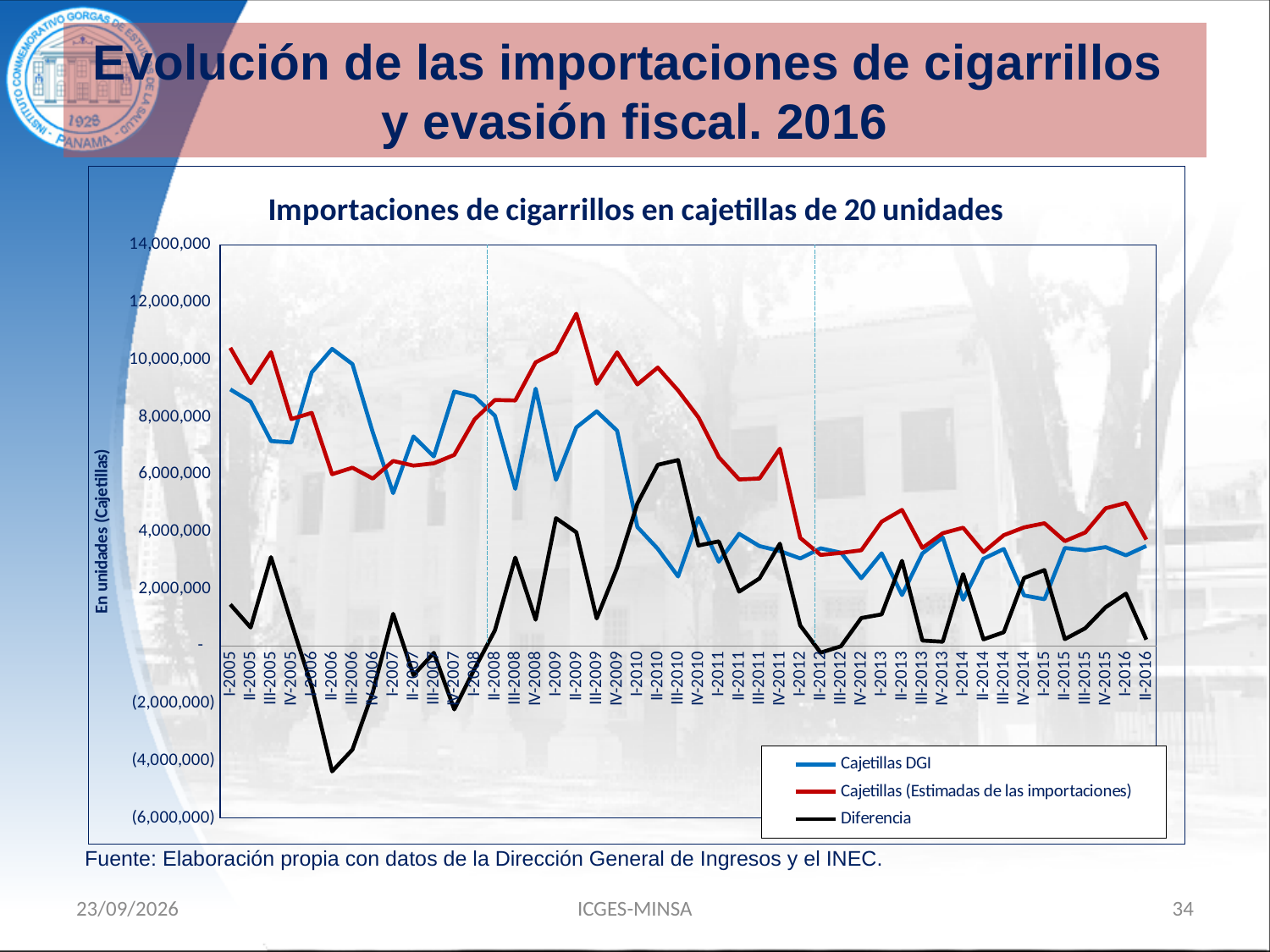
Is the value of Cajetillas (Estimadas de las importaciones) at I-2016 greater or less than 4,000,000? greater Is the value of Cajetillas (Estimadas de las importaciones) at II-2009 greater or less than 10,000,000? greater What is the label of the vertical axis? En unidades (Cajetillas) Is the value of Cajetillas DGI at I-2005 greater or less than 8,000,000? greater What kind of chart is shown on the slide? line chart How many series does the legend list? 3 At II-2009, which series is higher: Cajetillas DGI or Cajetillas (Estimadas de las importaciones)? Cajetillas (Estimadas de las importaciones) In which quarter does the Cajetillas (Estimadas de las importaciones) series reach its highest value? II-2009 At II-2006, which series is higher: Cajetillas DGI or Cajetillas (Estimadas de las importaciones)? Cajetillas DGI What is the title of the chart? Importaciones de cigarrillos en cajetillas de 20 unidades